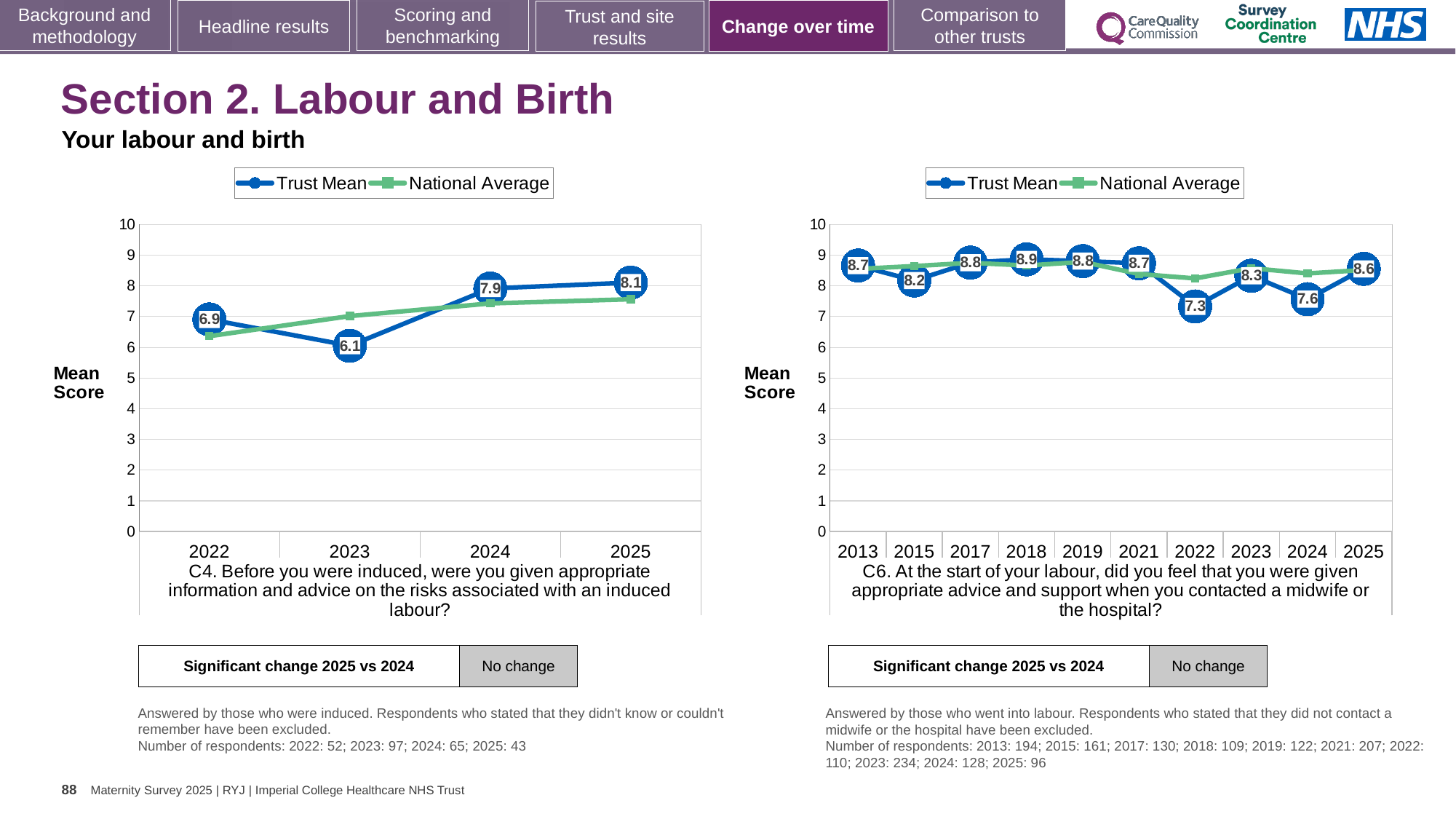
In the left chart (C4), is the National Average for 2022 greater or less than 7? less In the right chart (C6), what is the difference between the Trust Mean scores for 2021 and 2022? 1.4 In the left chart (C4), how many years are shown on the x axis? 4 In the left chart (C4), what is the Trust Mean score for 2023? 6.1 What type of chart is used on the left side of the slide (C4)? Line chart In the right chart (C6), which is larger, the Trust Mean score for 2024 or for 2025? 2025 In the right chart (C6), how many series does the legend list? 2 In the left chart (C4), what is the difference between the Trust Mean scores for 2025 and 2022? 1.2 In the right chart (C6), what is the Trust Mean score for 2022? 7.3 In the right chart (C6), which year has the highest Trust Mean score? 2018 In the left chart (C4), which year has the lowest Trust Mean score? 2023 In the left chart (C4), what is the Trust Mean score for 2025? 8.1